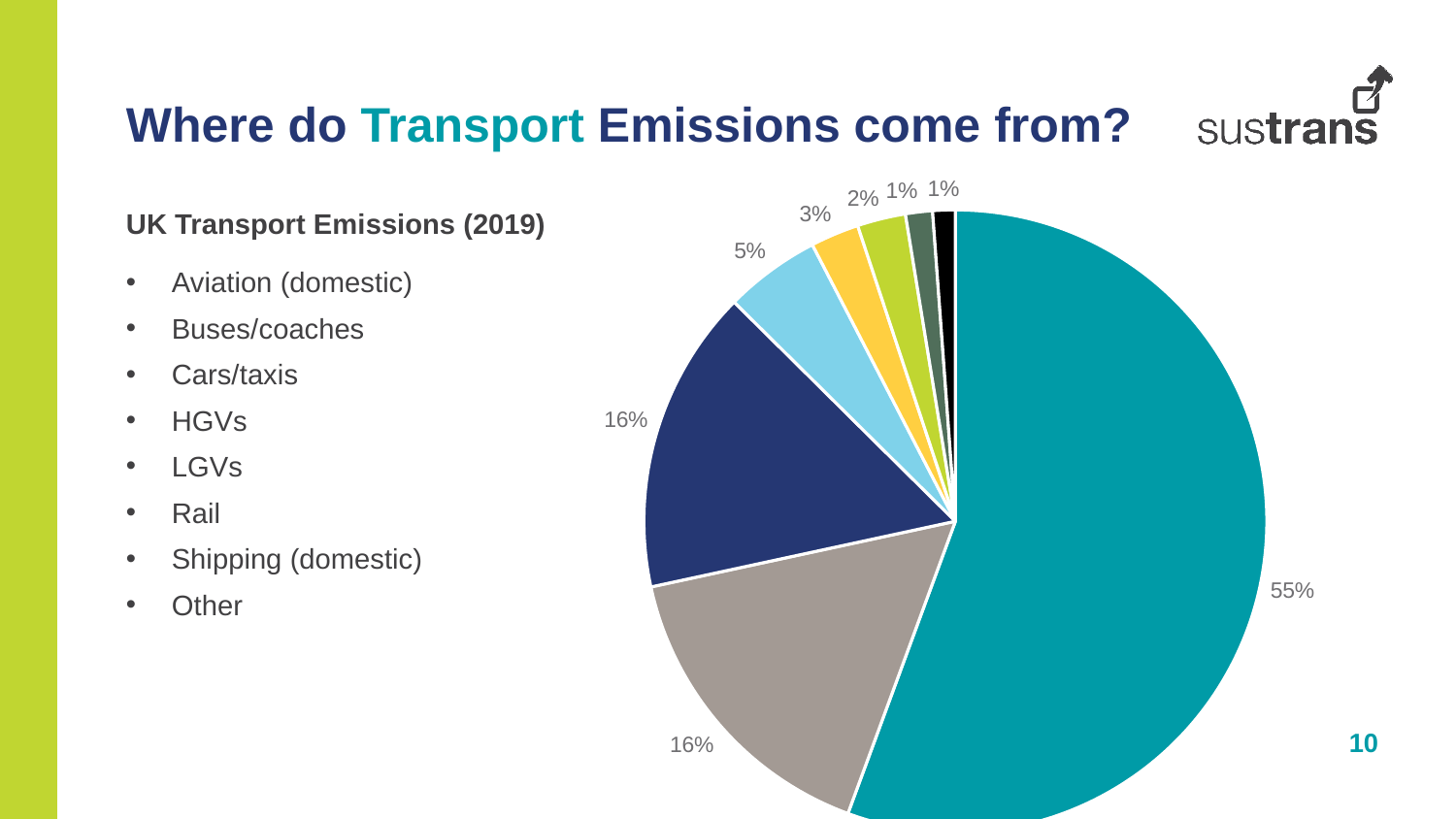
What is the value of the largest slice in the pie chart? 55% What do the two slices labelled 16% add up to? 32% What colour is the largest slice of the pie chart? Teal How many slices in the pie chart are labelled 1%? 2 What is the title of the slide containing the pie chart? Where do Transport Emissions come from? What is the difference between the largest slice (55%) and one of the 16% slices? 39 percentage points How many slices in the pie chart are labelled 16%? 2 What kind of chart is shown on the slide? Pie chart How many slices does the pie chart have? 8 Is the largest slice of the pie chart greater or less than 50%? greater Which is larger, the slice labelled 5% or the slice labelled 3%? The 5% slice What is the value of the smallest slices in the pie chart? 1%